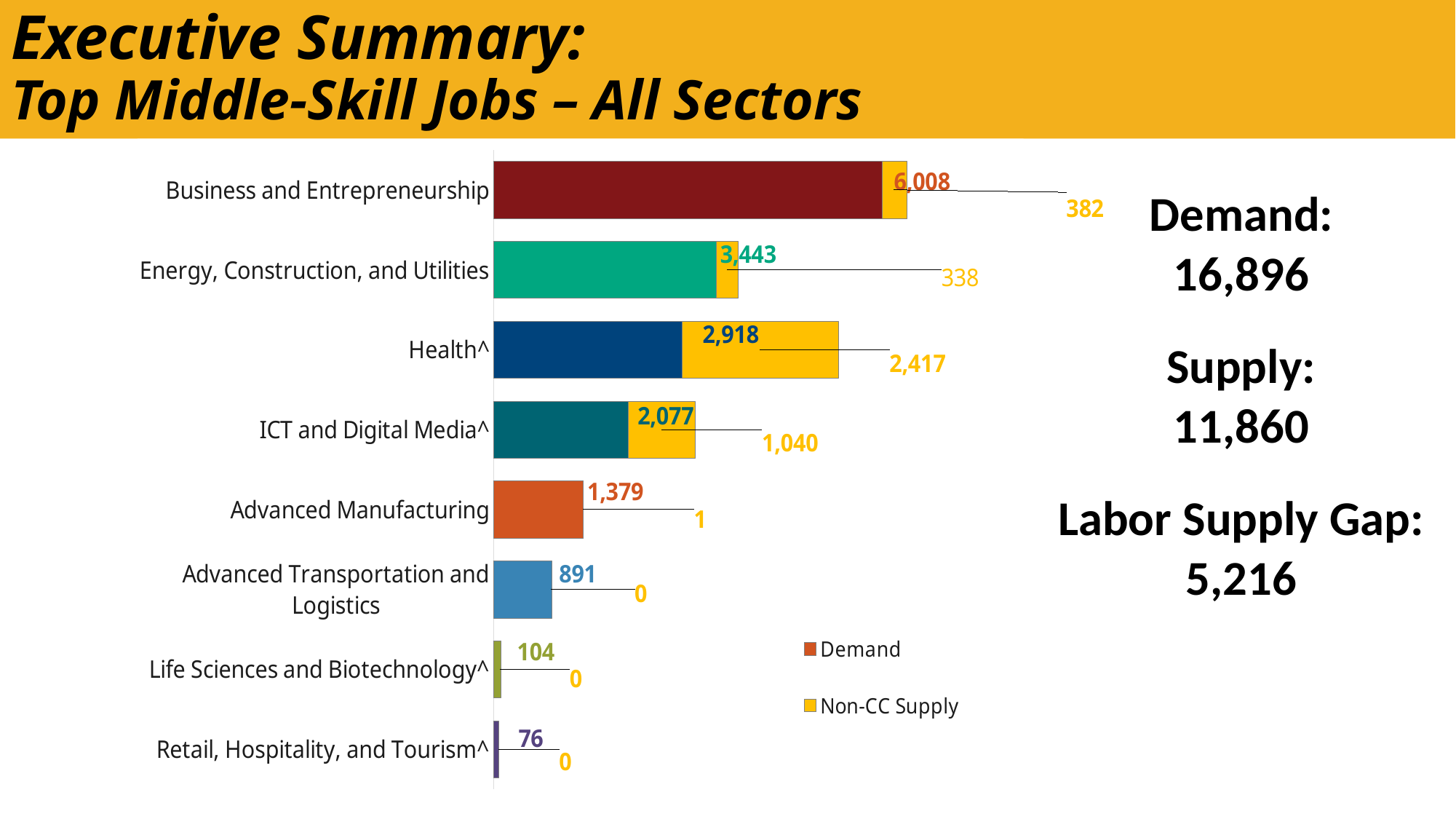
How many series does the legend list? 2 Which is larger: the Demand value for Advanced Manufacturing or the Demand value for ICT and Digital Media^? ICT and Digital Media^ Which sector has the highest Non-CC Supply value? Health^ What is the difference between the Demand values for Business and Entrepreneurship and Energy, Construction, and Utilities? 2,565 Which sector has the highest Demand value? Business and Entrepreneurship What is the Demand value for Advanced Transportation and Logistics? 891 What is the Demand value for Health^? 2,918 What is the Non-CC Supply value for ICT and Digital Media^? 1,040 How many sectors are shown in the chart? 8 What is the Non-CC Supply value for Business and Entrepreneurship? 382 What kind of chart is shown on the slide? Bar chart Which sector has the lowest Demand value? Retail, Hospitality, and Tourism^